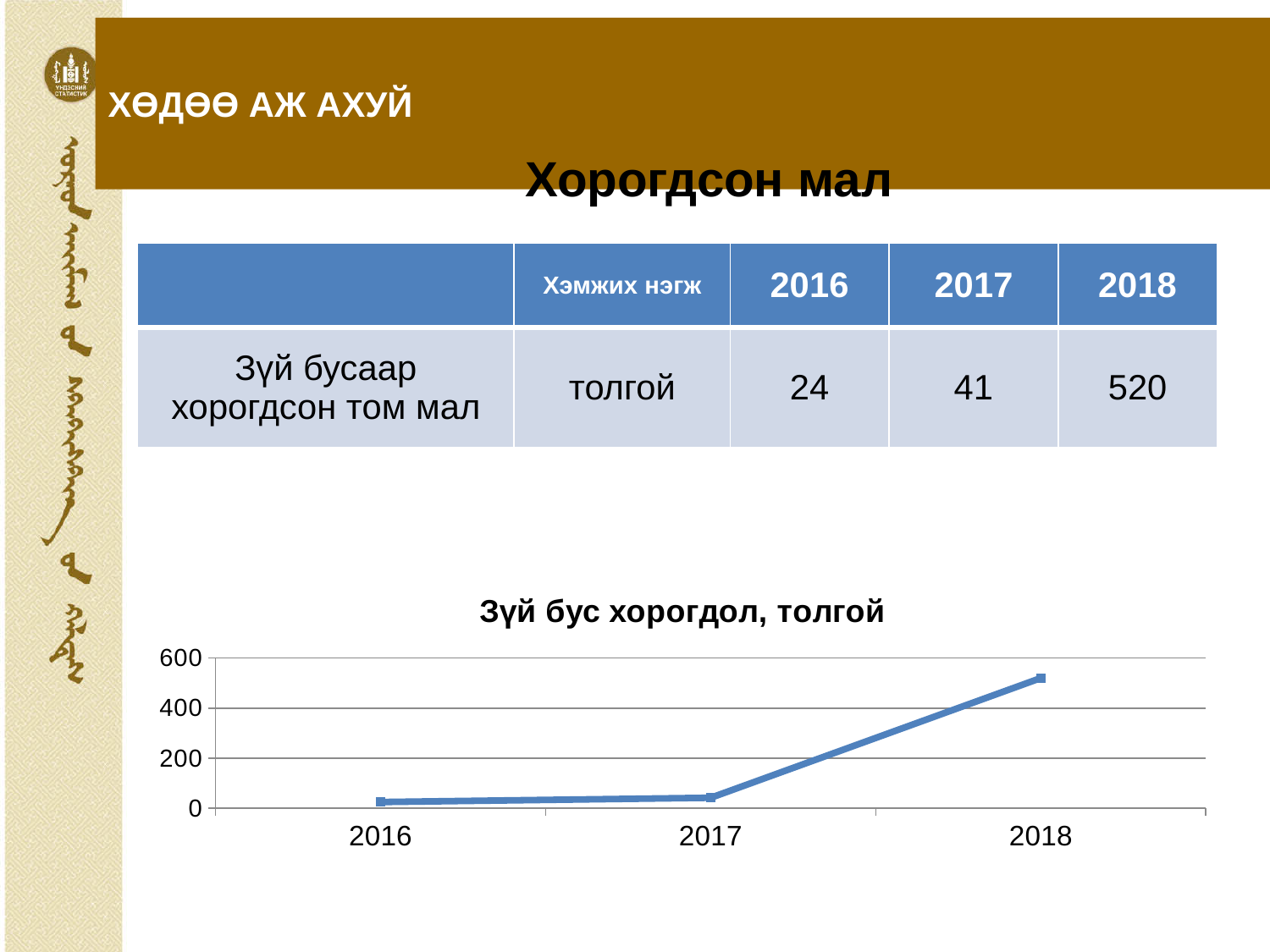
Using the values printed on the slide, what is the difference between 2018 and 2017? 479 Which year has the highest value in the chart? 2018 Is the value for 2018 in the chart greater or less than 400? greater Which year has the lowest value in the chart? 2016 Do the values in the chart rise or fall from 2016 to 2018? rise According to the slide, what is the value for 2016? 24 Is the value for 2016 in the chart greater or less than 200? less What kind of chart is shown on the slide? line chart Is the value for 2017 in the chart greater or less than 200? less According to the slide, what is the value for 2018? 520 How many years are plotted on the x axis of the chart? 3 What is the title of the chart? Зүй бус хорогдол, толгой